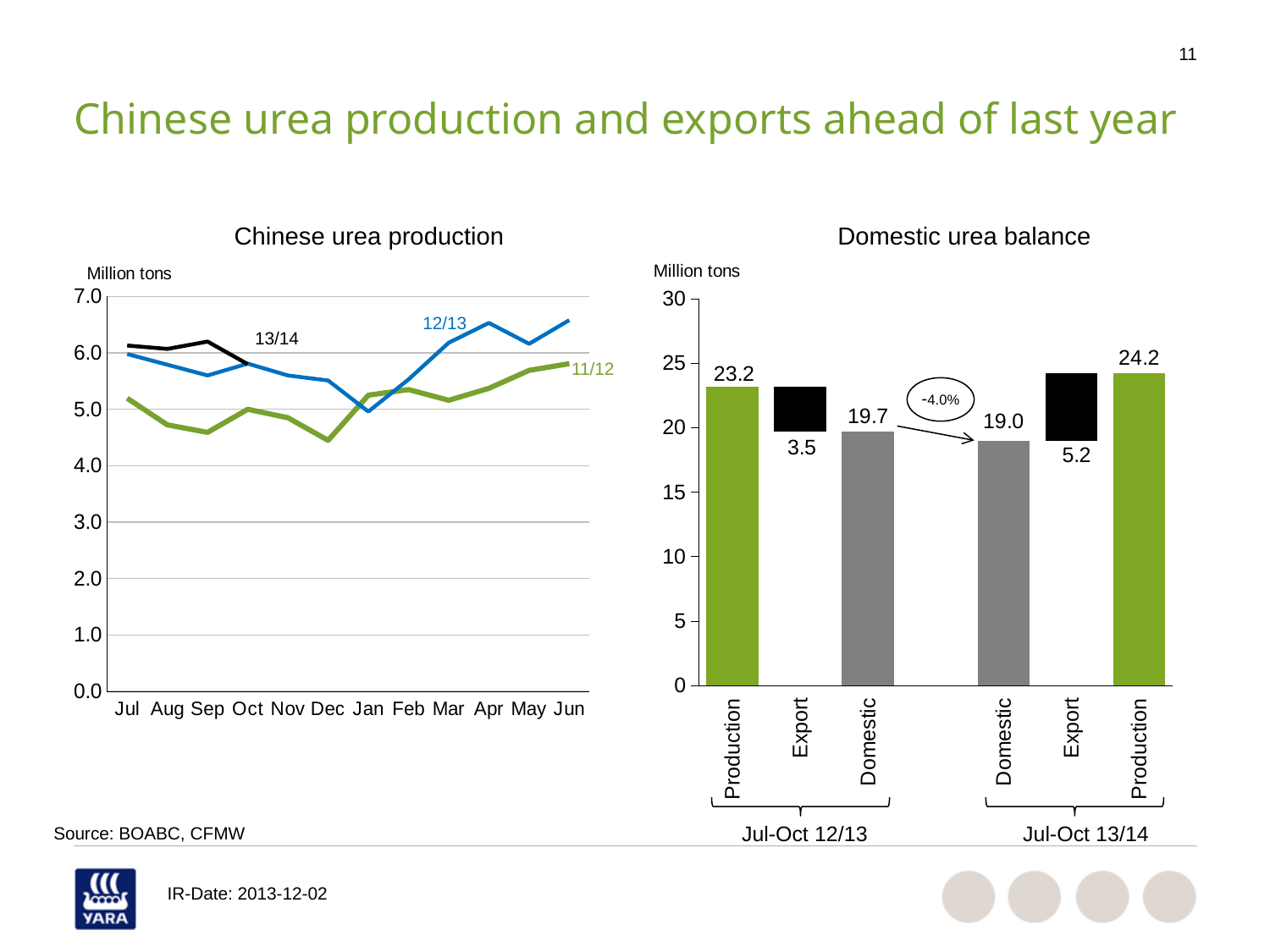
In the 'Domestic urea balance' chart, what is the difference between Export in Jul-Oct 13/14 and Export in Jul-Oct 12/13? 1.7 In the 'Domestic urea balance' chart, what is the value of Domestic for Jul-Oct 13/14? 19.0 How many series are plotted in the 'Chinese urea production' chart? 3 In the 'Domestic urea balance' chart, which bar has the highest value? Production, Jul-Oct 13/14 In the 'Domestic urea balance' chart, by how much does Production in Jul-Oct 13/14 exceed Production in Jul-Oct 12/13? 1.0 In the 'Domestic urea balance' chart, what is the value of Export for Jul-Oct 13/14? 5.2 In the 'Domestic urea balance' chart, is Domestic larger in Jul-Oct 12/13 or Jul-Oct 13/14? Jul-Oct 12/13 What kind of chart is the 'Chinese urea production' chart? Line chart In the 'Domestic urea balance' chart, what is the value of Production for Jul-Oct 12/13? 23.2 In the 'Chinese urea production' chart, is the value for 11/12 in Dec greater or less than 5.0? less In the 'Domestic urea balance' chart, which bar has the lowest value? Export, Jul-Oct 12/13 In the 'Chinese urea production' chart, is the value for 12/13 in Apr greater or less than 6.0? greater